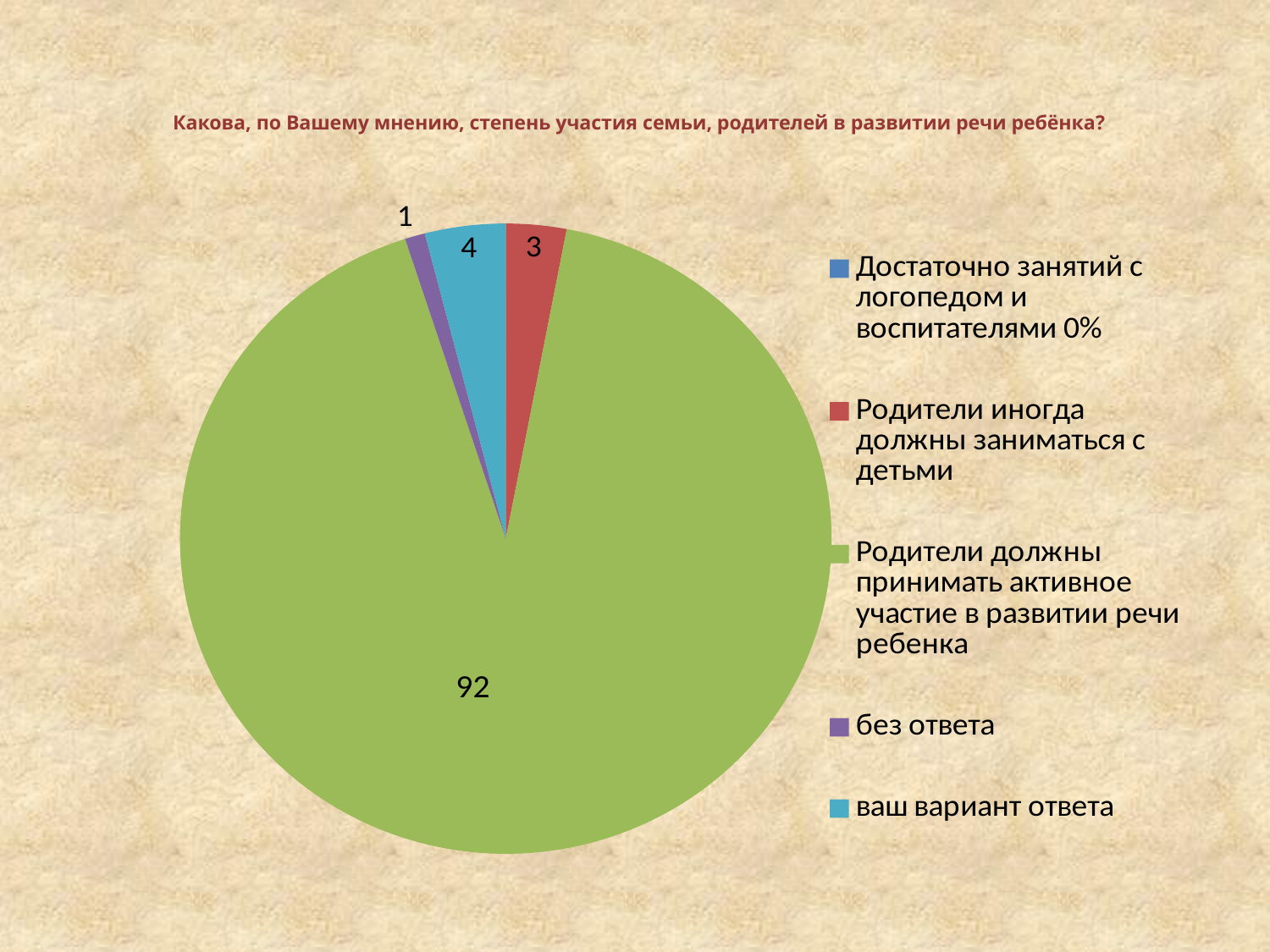
How many entries does the legend list? 5 What is the value for "ваш вариант ответа"? 4 What is the total of the labelled slice values in the pie? 100 What colour is the slice for "Родители должны принимать активное участие в развитии речи ребенка"? green What is the value for "Родители иногда должны заниматься с детьми"? 3 Which is larger: the value for "ваш вариант ответа" or the value for "без ответа"? ваш вариант ответа Which category with a visible slice has the smallest value? без ответа What is the difference between the values for "ваш вариант ответа" and "Родители иногда должны заниматься с детьми"? 1 What is the value for "Родители должны принимать активное участие в развитии речи ребенка"? 92 What is the value for "без ответа"? 1 Which category has the largest slice of the pie? Родители должны принимать активное участие в развитии речи ребенка What kind of chart is shown on the slide? pie chart